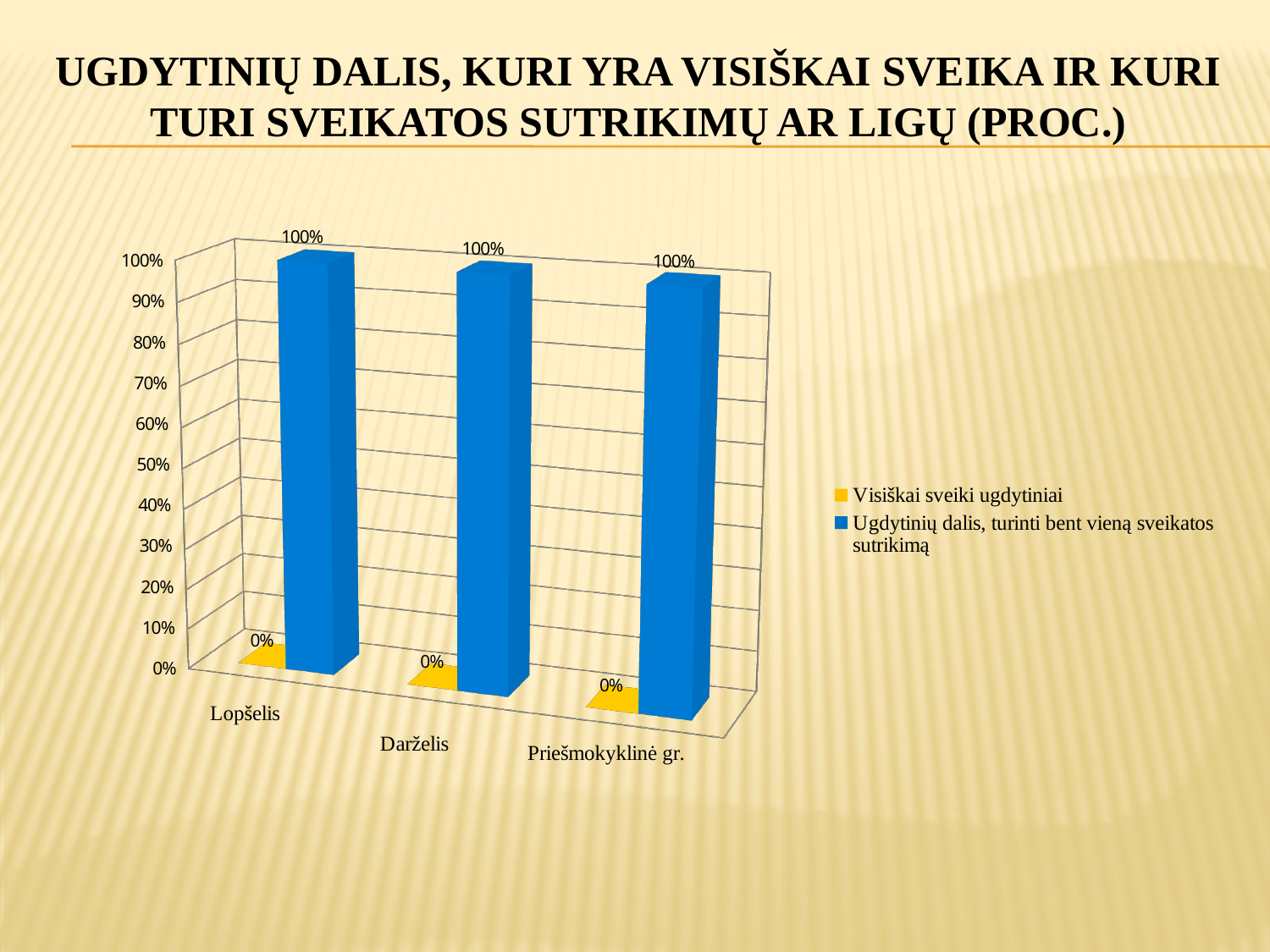
How many series does the legend list? 2 What is the value for 'Ugdytinių dalis, turinti bent vieną sveikatos sutrikimą' in Priešmokyklinė gr.? 100% What is the difference between the two series' values in Lopšelis? 100% What is the value for 'Visiškai sveiki ugdytiniai' in Priešmokyklinė gr.? 0% Which series is larger in Darželis: 'Visiškai sveiki ugdytiniai' or 'Ugdytinių dalis, turinti bent vieną sveikatos sutrikimą'? Ugdytinių dalis, turinti bent vieną sveikatos sutrikimą What is the value for 'Visiškai sveiki ugdytiniai' in Darželis? 0% What is the value for 'Ugdytinių dalis, turinti bent vieną sveikatos sutrikimą' in Lopšelis? 100% How many categories are shown on the x axis? 3 What kind of chart is shown on the slide? Bar chart What colour are the bars for 'Visiškai sveiki ugdytiniai'? Yellow Is the value for 'Ugdytinių dalis, turinti bent vieną sveikatos sutrikimą' in Darželis greater or less than 50%? greater Does the value for 'Ugdytinių dalis, turinti bent vieną sveikatos sutrikimą' rise, fall or stay the same across the categories? Stays the same